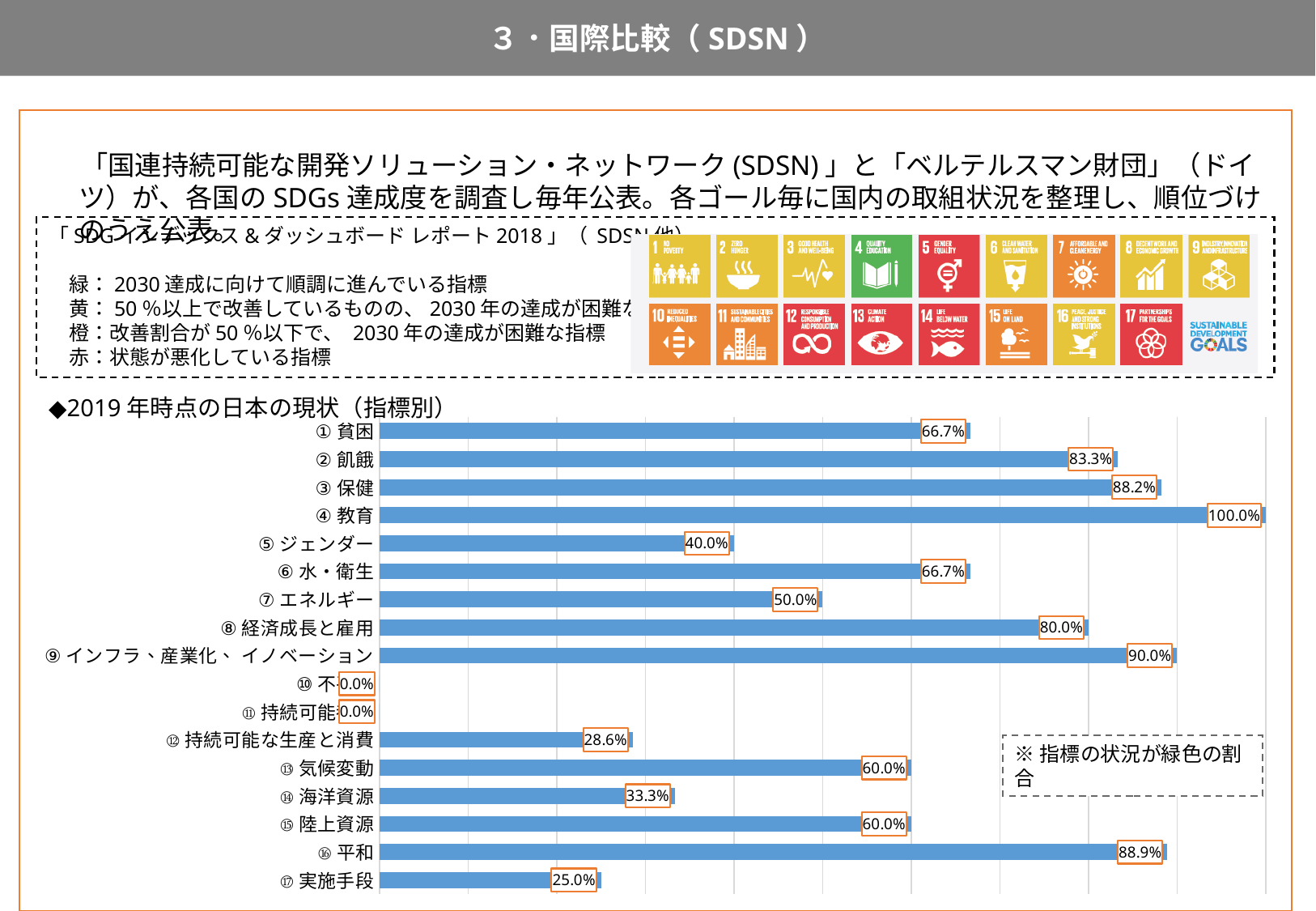
How many categories are shown in the chart? 17 What is the value for ⑨ インフラ、産業化、イノベーション? 90.0% Which category has the highest value? ④ 教育 What is the difference between the values for ④ 教育 and ⑤ ジェンダー? 60.0 percentage points What is the difference between the values for ② 飢餓 and ⑭ 海洋資源? 50.0 percentage points How many categories have a value of 0.0%? 2 What kind of chart is shown on the slide? Bar chart Which is larger, the value for ③ 保健 or the value for ⑧ 経済成長と雇用? ③ 保健 What is the value for ⑤ ジェンダー? 40.0% What is the value for ⑫ 持続可能な生産と消費? 28.6% What is the value for ⑯ 平和? 88.9% What is the value for ④ 教育? 100.0%